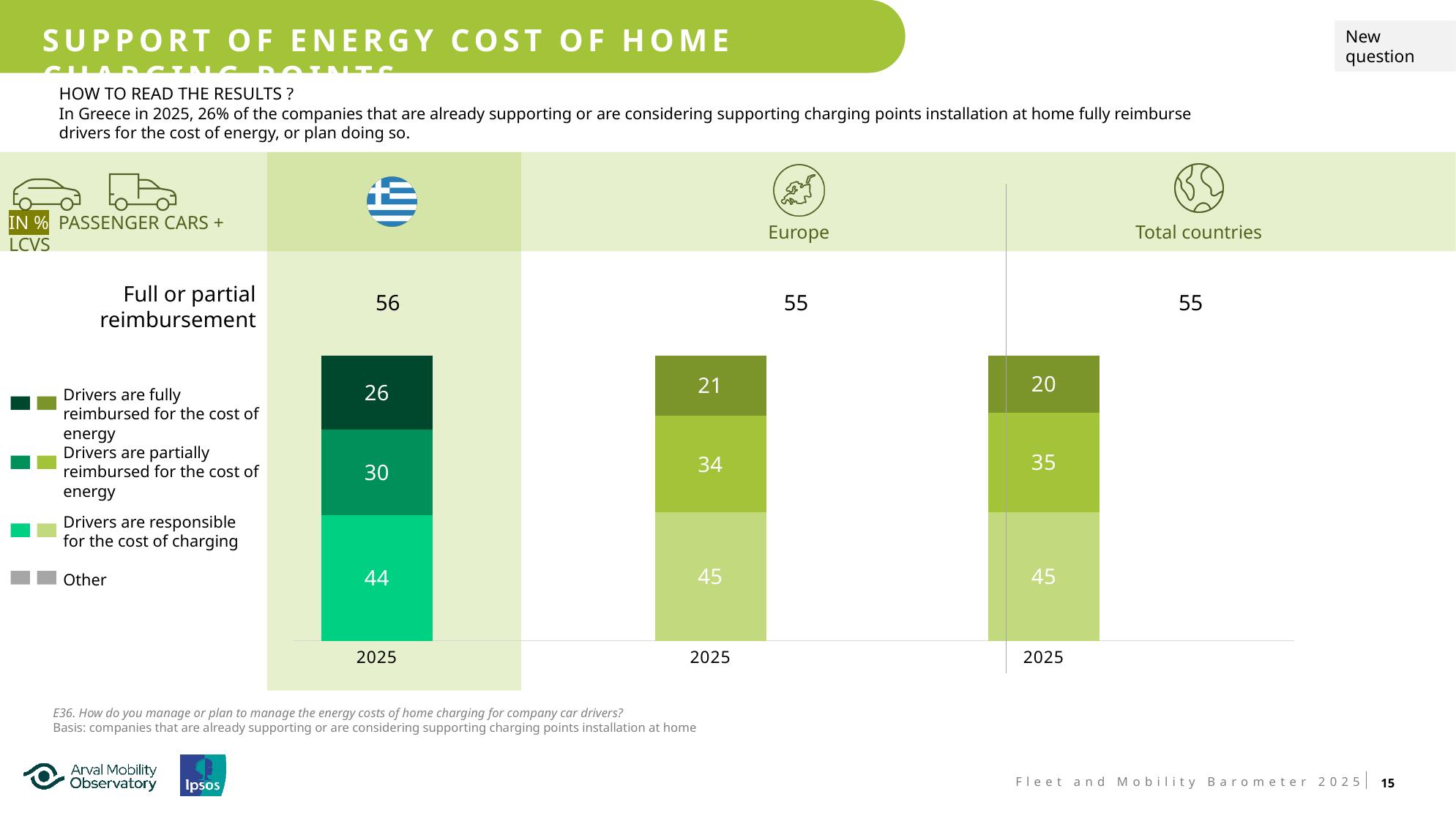
What is the 'Full or partial reimbursement' figure shown above the Greece bar? 56 In the Europe bar, what is the value for drivers being partially reimbursed for the cost of energy? 34 Which segment is the largest in the Greece bar? Drivers are responsible for the cost of charging What is the difference between the 'partially reimbursed' values for Europe and Greece? 4 In the Total countries bar, what is the value for drivers being responsible for the cost of charging? 45 How many entries does the legend list? 4 Which has a higher 'fully reimbursed' value, Greece or Total countries? Greece What kind of chart is shown on the slide? Stacked bar chart What is the total of the three labelled segments in the Greece bar? 100 What is the difference between the 'Full or partial reimbursement' figures for Greece and Europe? 1 In the Greece bar (flag), what percentage of companies say drivers are fully reimbursed for the cost of energy? 26 How many stacked bars are shown on the slide? 3